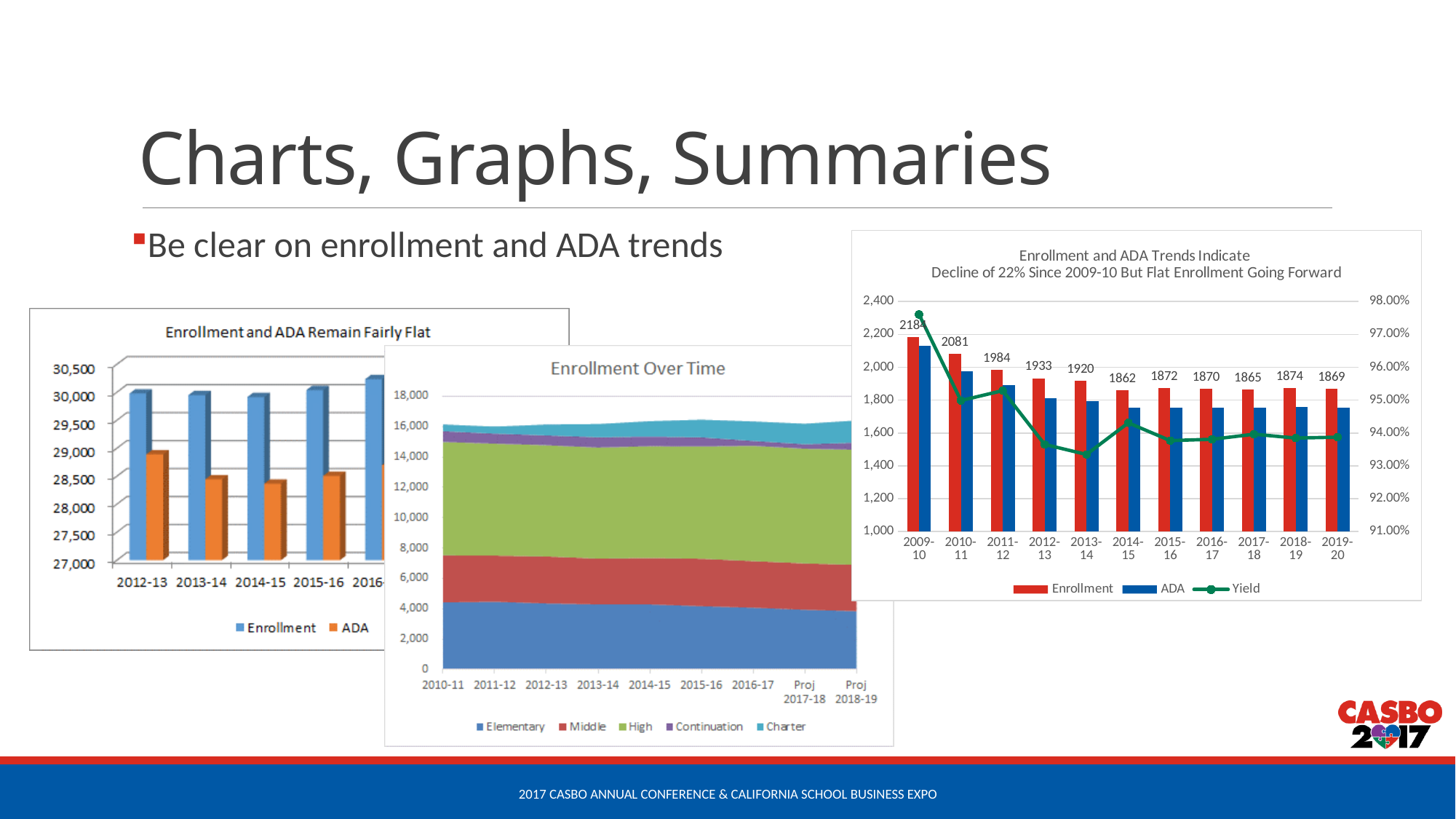
In the chart titled 'Enrollment and ADA Trends Indicate Decline of 22% Since 2009-10 But Flat Enrollment Going Forward', does Enrollment rise or fall from 2009-10 to 2013-14? fall In the chart titled 'Enrollment and ADA Trends Indicate Decline of 22% Since 2009-10 But Flat Enrollment Going Forward', what is the difference between the Enrollment values for 2009-10 and 2019-20? 315 In the chart titled 'Enrollment and ADA Remain Fairly Flat', is the Enrollment value for 2012-13 greater or less than 29,500? greater How many series does the legend of the 'Enrollment Over Time' chart list? 5 In the chart titled 'Enrollment and ADA Trends Indicate Decline of 22% Since 2009-10 But Flat Enrollment Going Forward', how many series does the legend list? 3 In the chart titled 'Enrollment and ADA Trends Indicate Decline of 22% Since 2009-10 But Flat Enrollment Going Forward', what is the Enrollment value for 2009-10? 2184 What kind of chart is 'Enrollment Over Time'? stacked area chart In the chart titled 'Enrollment and ADA Trends Indicate Decline of 22% Since 2009-10 But Flat Enrollment Going Forward', which year has the highest Enrollment? 2009-10 In the chart titled 'Enrollment and ADA Trends Indicate Decline of 22% Since 2009-10 But Flat Enrollment Going Forward', what is the Enrollment value for 2013-14? 1920 In the chart titled 'Enrollment and ADA Trends Indicate Decline of 22% Since 2009-10 But Flat Enrollment Going Forward', which year has the lowest Enrollment? 2014-15 In the chart titled 'Enrollment and ADA Trends Indicate Decline of 22% Since 2009-10 But Flat Enrollment Going Forward', how many years are shown on the x axis? 11 In the chart titled 'Enrollment and ADA Remain Fairly Flat', which is larger for 2012-13, Enrollment or ADA? Enrollment